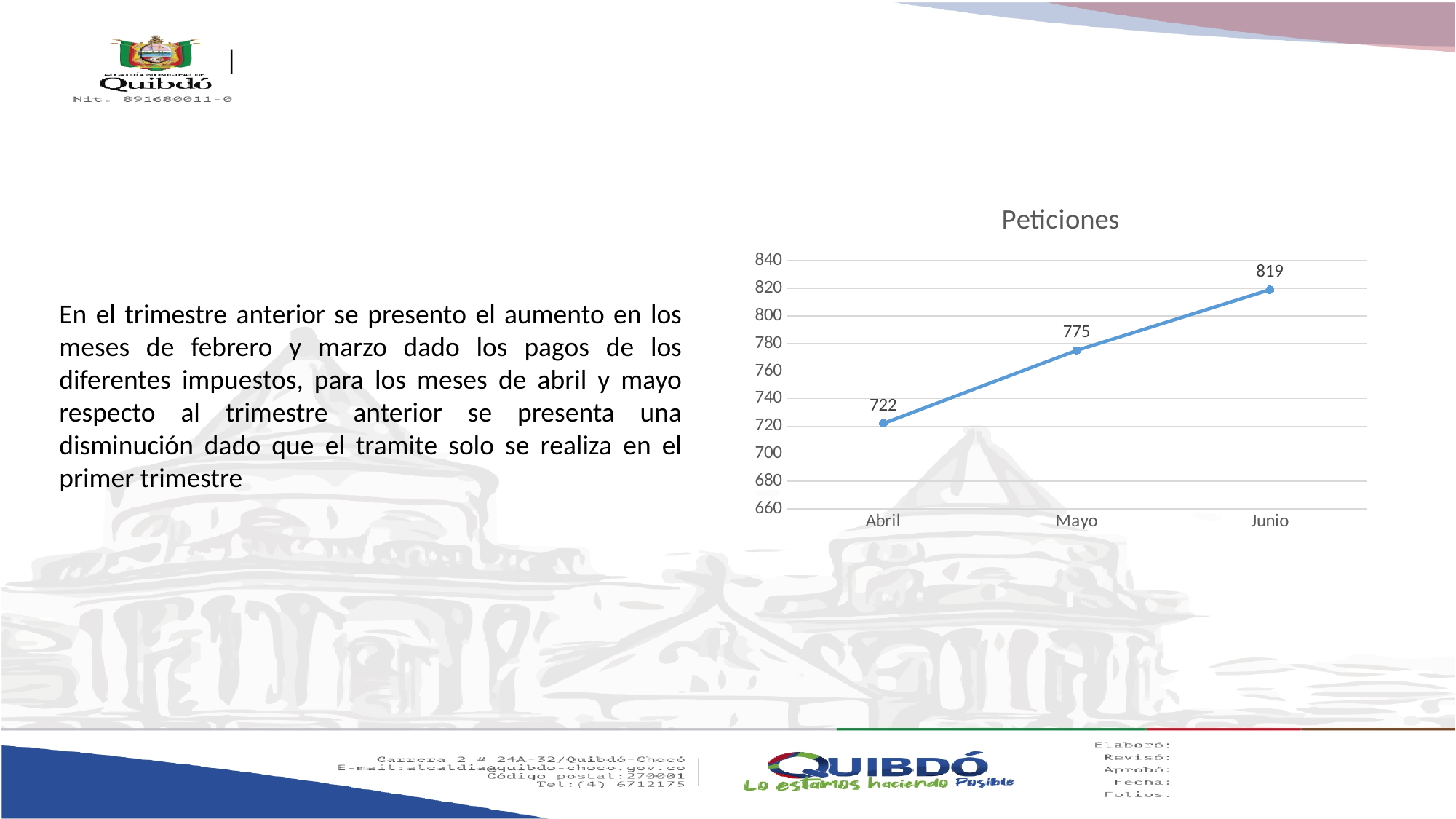
What is the value for Junio? 819 What is the difference between the values for Mayo and Abril? 53 Which is larger, the value for Mayo or the value for Junio? Junio Which month has the highest value? Junio What is the value for Mayo? 775 Do the values rise or fall from Abril to Junio? rise Is the value for Abril greater or less than 740? less What is the difference between the values for Junio and Abril? 97 What kind of chart is shown? line chart What is the value for Abril? 722 Which month has the lowest value? Abril How many months are plotted on the chart? 3